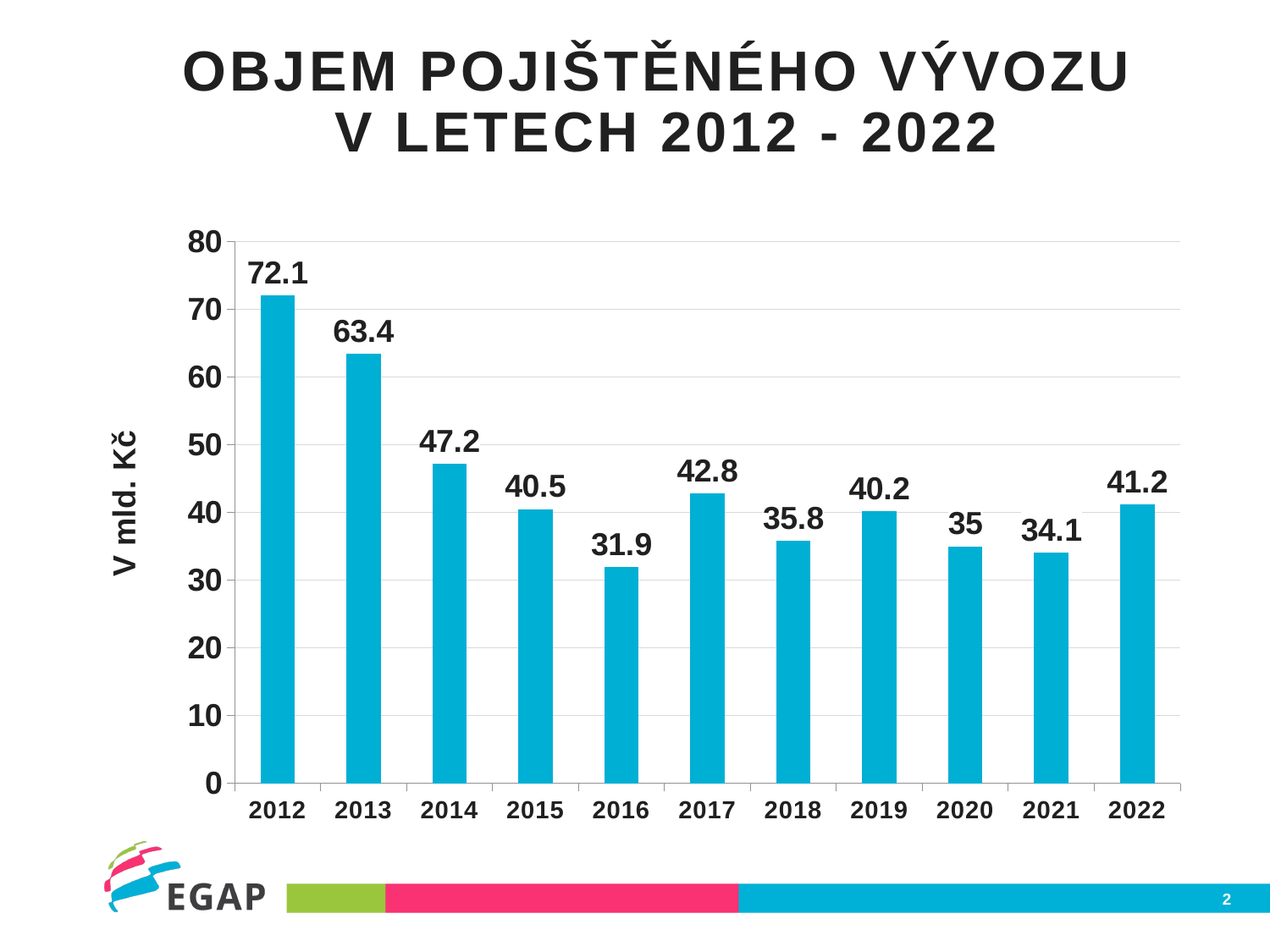
What is the value for 2012? 72.1 What is the difference between the values for 2022 and 2021? 7.1 What is the value for 2022? 41.2 Which is larger, the value for 2017 or the value for 2019? 2017 What is the difference between the values for 2012 and 2013? 8.7 How many years are shown on the x axis? 11 What is the label of the vertical axis? V mld. Kč Is the value for 2014 greater or less than 50? less What kind of chart is shown on the slide? bar chart Which year has the highest value? 2012 Which year has the lowest value? 2016 What is the value for 2016? 31.9